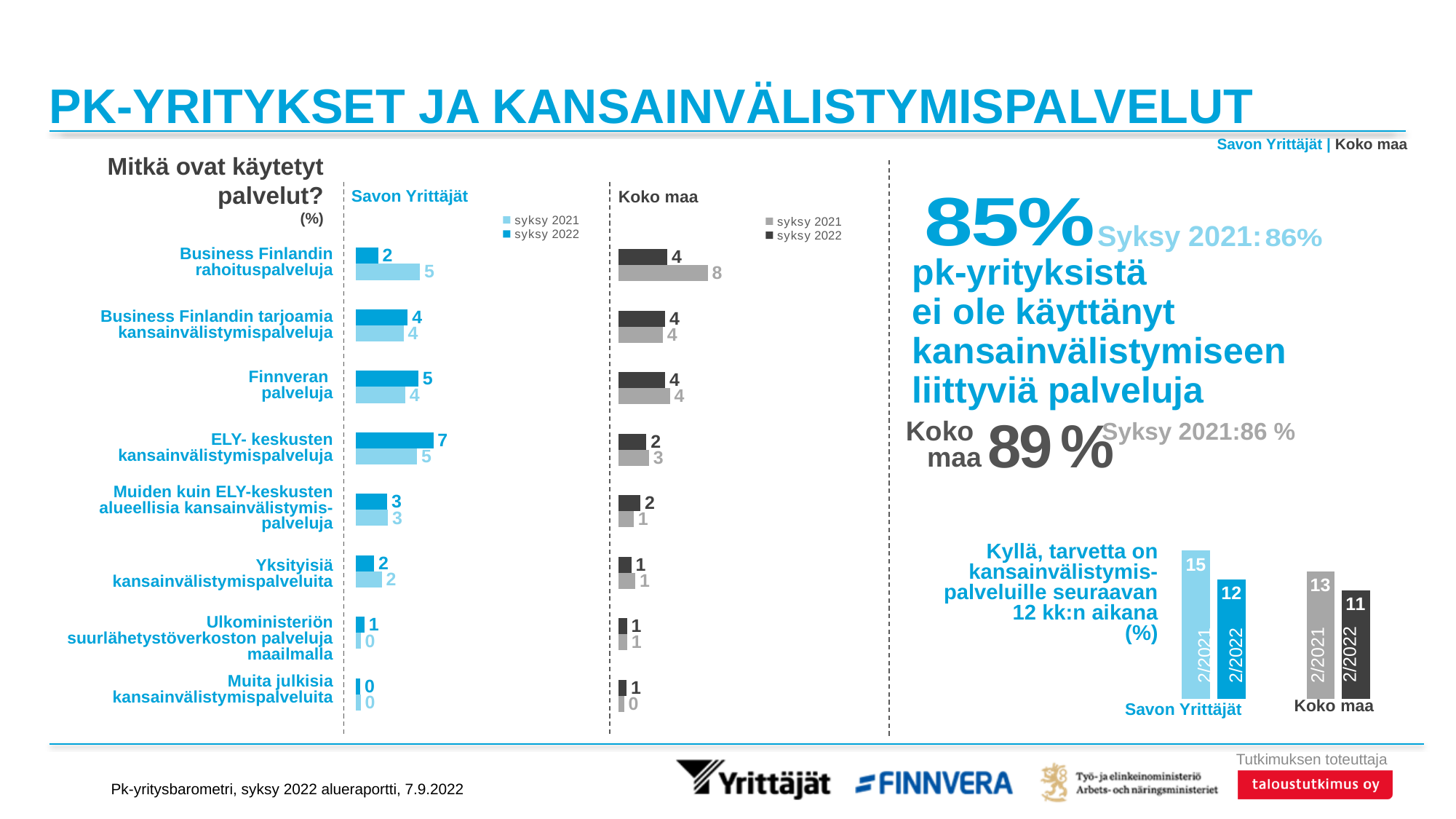
In the Savon Yrittäjät chart, what is the syksy 2022 value for ELY- keskusten kansainvälistymispalveluja? 7 How many categories are shown in the Savon Yrittäjät chart? 8 In the chart at the bottom right (Kyllä, tarvetta on kansainvälistymispalveluille seuraavan 12 kk:n aikana), what is the difference between the 2/2021 and 2/2022 values for Koko maa? 2 How many series does the legend of the Koko maa chart list? 2 In the Savon Yrittäjät chart, what is the difference between the syksy 2021 and syksy 2022 values for Business Finlandin rahoituspalveluja? 3 In the Koko maa chart, which category has the highest syksy 2021 value? Business Finlandin rahoituspalveluja In the chart at the bottom right (Kyllä, tarvetta on kansainvälistymispalveluille seuraavan 12 kk:n aikana), what is the 2/2022 value for Savon Yrittäjät? 12 In the Savon Yrittäjät chart, what is the syksy 2022 value for Finnveran palveluja? 5 In the Savon Yrittäjät chart, which category has the highest syksy 2022 value? ELY- keskusten kansainvälistymispalveluja What kind of chart is the Savon Yrittäjät chart? bar chart In the Koko maa chart, which is larger for ELY- keskusten kansainvälistymispalveluja: the syksy 2021 value or the syksy 2022 value? syksy 2021 In the Koko maa chart, what is the syksy 2021 value for Business Finlandin rahoituspalveluja? 8